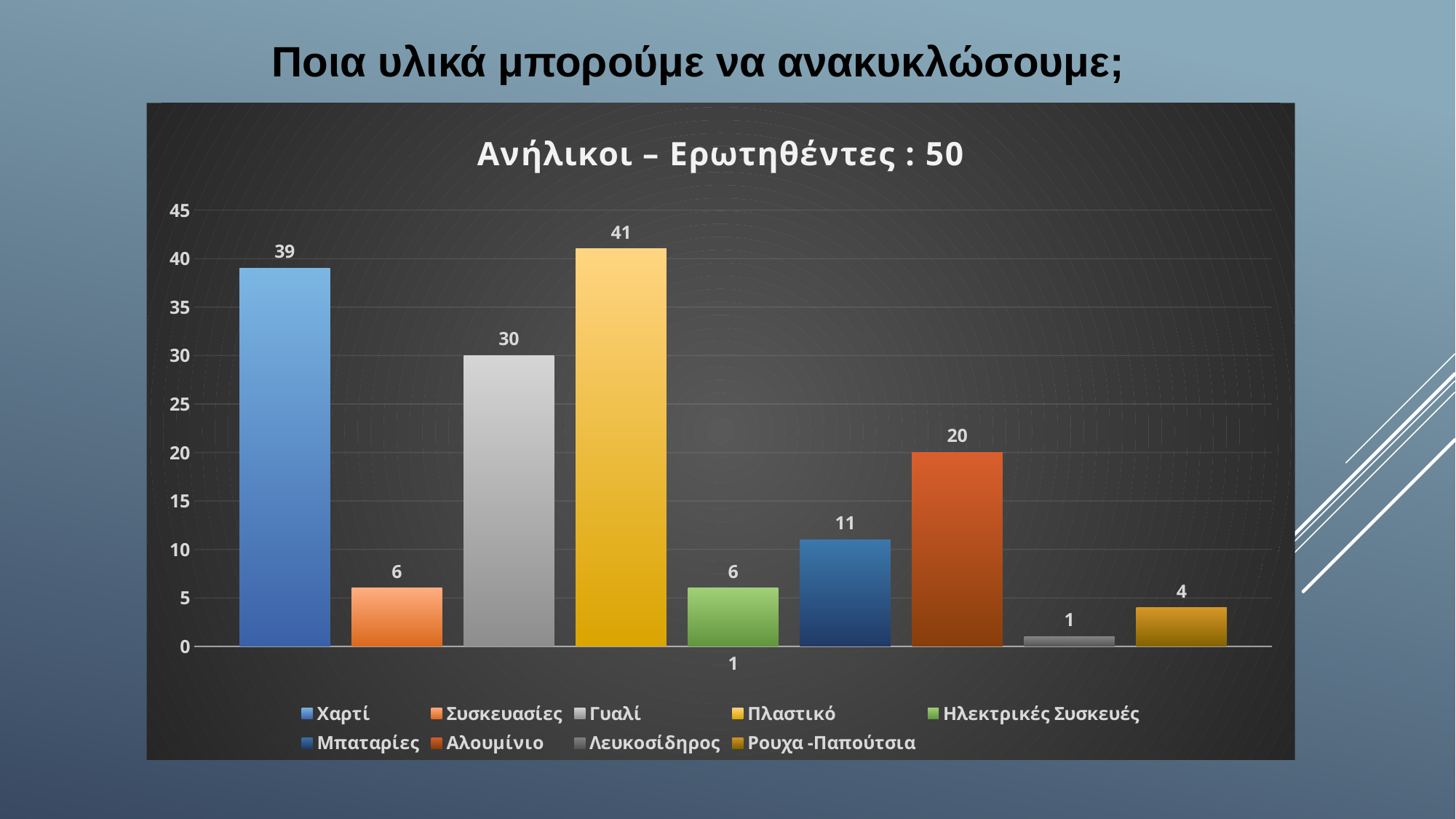
Which is larger, the value for Αλουμίνιο or the value for Μπαταρίες? Αλουμίνιο What is the title of the chart? Ανήλικοι – Ερωτηθέντες : 50 What is the difference between the values for Γυαλί and Μπαταρίες? 19 What is the value for Πλαστικό? 41 What is the value for Αλουμίνιο? 20 Which series has the lowest value? Λευκοσίδηρος What is the value for Χαρτί? 39 How many series does the legend list? 9 Which series has the highest value? Πλαστικό What kind of chart is shown on the slide? Bar chart What is the difference between the values for Πλαστικό and Χαρτί? 2 What is the value for Λευκοσίδηρος? 1